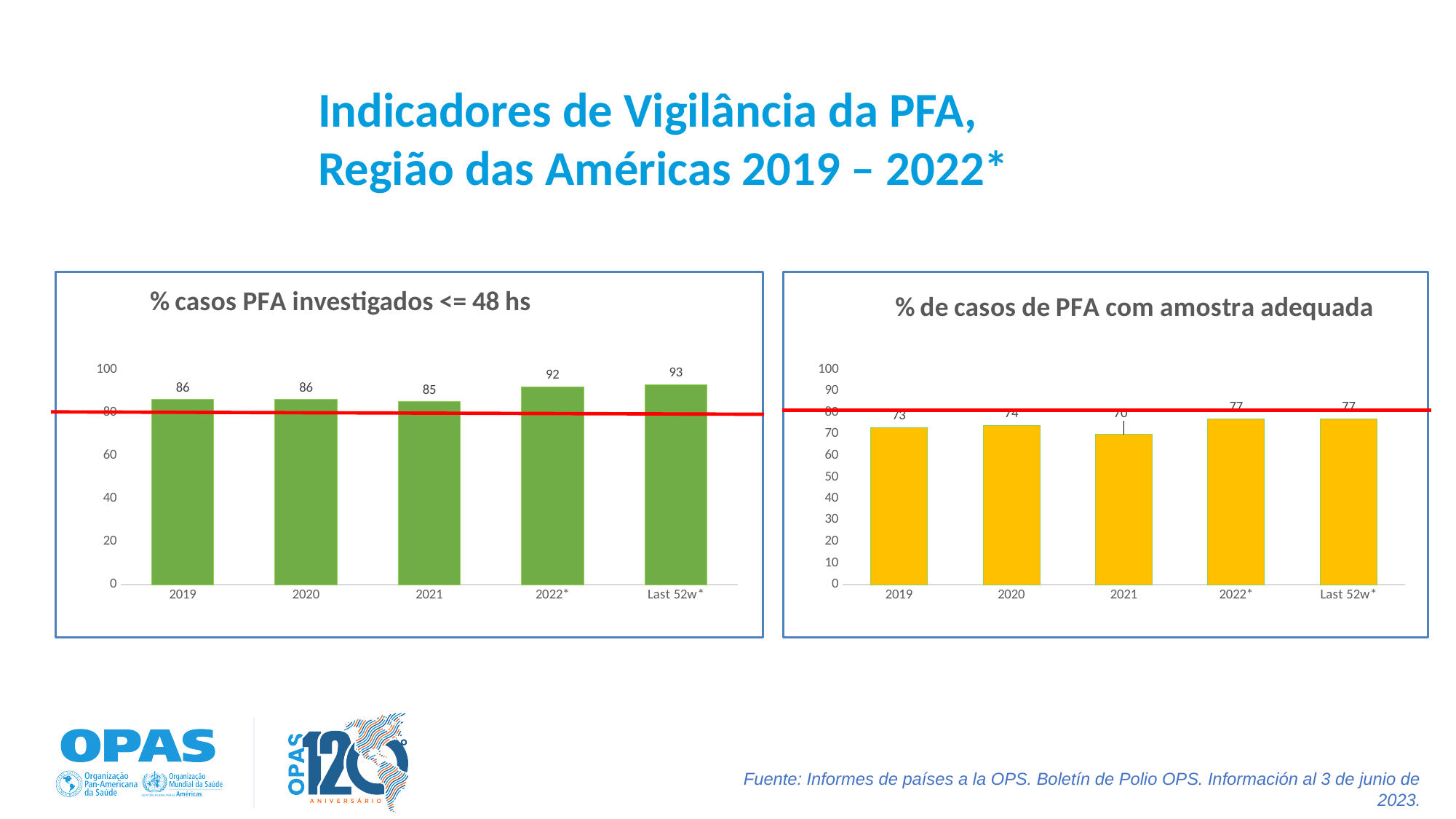
In the chart titled '% de casos de PFA com amostra adequada', what is the difference between the values for 2022* and 2019? 4 In the chart titled '% casos PFA investigados <= 48 hs', how many bars are plotted? 5 In the chart titled '% casos PFA investigados <= 48 hs', what is the value for 2021? 85 In the chart titled '% casos PFA investigados <= 48 hs', which category has the highest value? Last 52w* What kind of chart is the chart titled '% de casos de PFA com amostra adequada'? bar chart In the chart titled '% casos PFA investigados <= 48 hs', which category has the lowest value? 2021 In the chart titled '% de casos de PFA com amostra adequada', what is the value for 2021? 70 In the chart titled '% de casos de PFA com amostra adequada', is the value for 2020 greater or less than 80? less In the chart titled '% casos PFA investigados <= 48 hs', what is the value for Last 52w*? 93 In the chart titled '% casos PFA investigados <= 48 hs', what is the difference between the values for 2022* and 2021? 7 In the chart titled '% de casos de PFA com amostra adequada', what is the value for 2019? 73 In the chart titled '% de casos de PFA com amostra adequada', which category has the lowest value? 2021